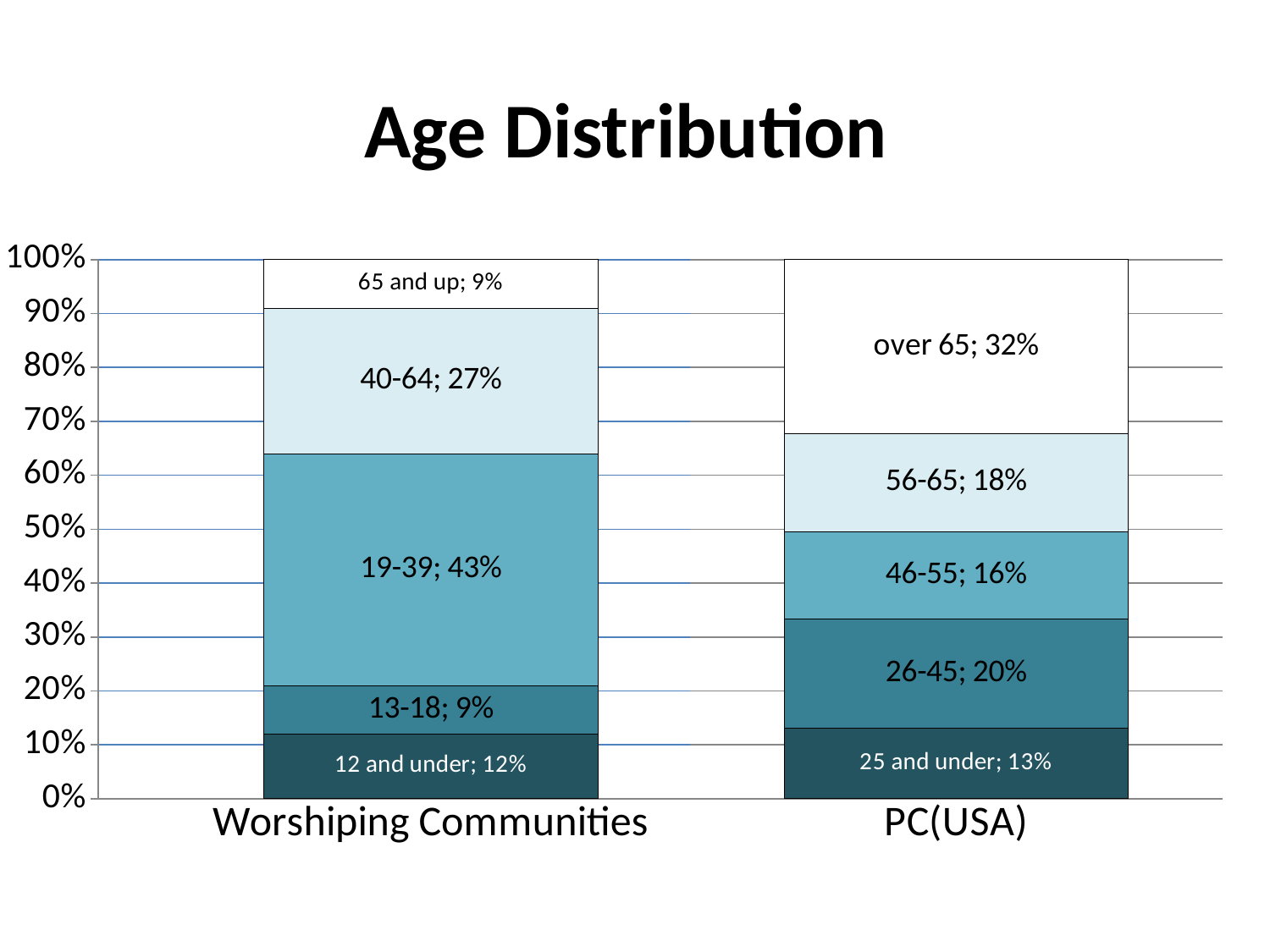
What is the difference between the 40-64 segment in the Worshiping Communities bar and the 56-65 segment in the PC(USA) bar? 9% How many bars are shown on the chart? 2 Which age segment is the largest in the PC(USA) bar? over 65 Which age segment is the smallest in the PC(USA) bar? 25 and under What kind of chart is shown on the slide? Stacked bar chart What is the value for the 12 and under segment in the Worshiping Communities bar? 12% What is the value for the 46-55 segment in the PC(USA) bar? 16% What is the value for the 19-39 segment in the Worshiping Communities bar? 43% What is the title of the chart? Age Distribution Which is larger: the 65 and up segment for Worshiping Communities or the over 65 segment for PC(USA)? over 65 segment for PC(USA) Which age segment is the largest in the Worshiping Communities bar? 19-39 What is the value for the over 65 segment in the PC(USA) bar? 32%